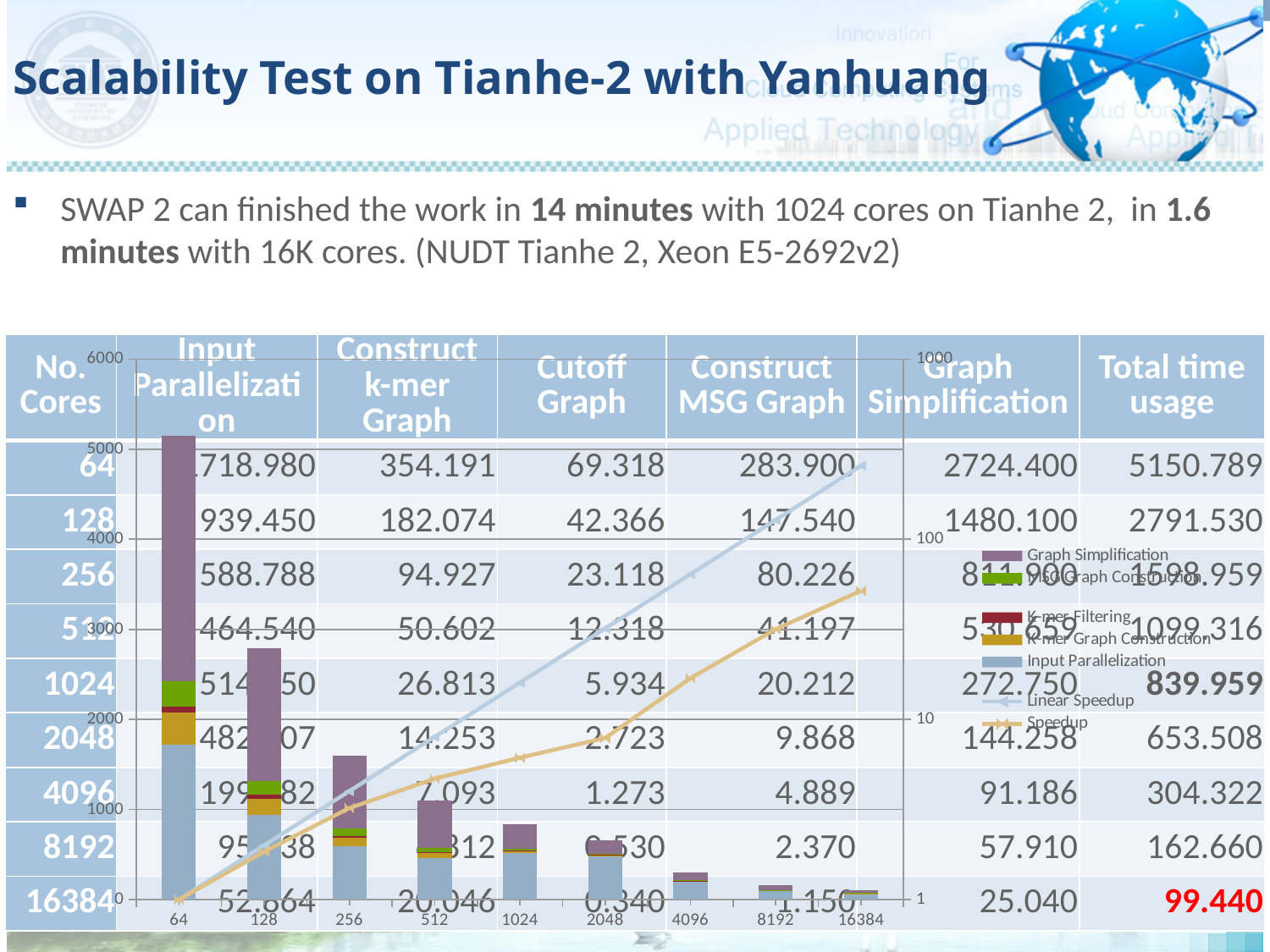
How many core-count categories are shown along the x axis of the chart? 9 What kind of chart is shown on the slide? A combination of a stacked bar chart and line chart Does the Speedup line rise or fall as the number of cores increases? Rise Is the total height of the stacked bar for 1024 cores greater or less than 1000? less Is the total height of the stacked bar for 128 cores greater or less than 2000? greater Which series forms the bottom segment of each stacked bar in the chart? Input Parallelization Is the total height of the stacked bar for 64 cores greater or less than 5000? greater Which core count has the shortest stacked bar in the chart? 16384 Which is taller in the chart, the stacked bar for 256 cores or the stacked bar for 2048 cores? 256 cores Do the stacked bars rise or fall as the number of cores increases along the x axis? Fall How many series does the chart's legend list? 7 Which core count has the tallest stacked bar in the chart? 64